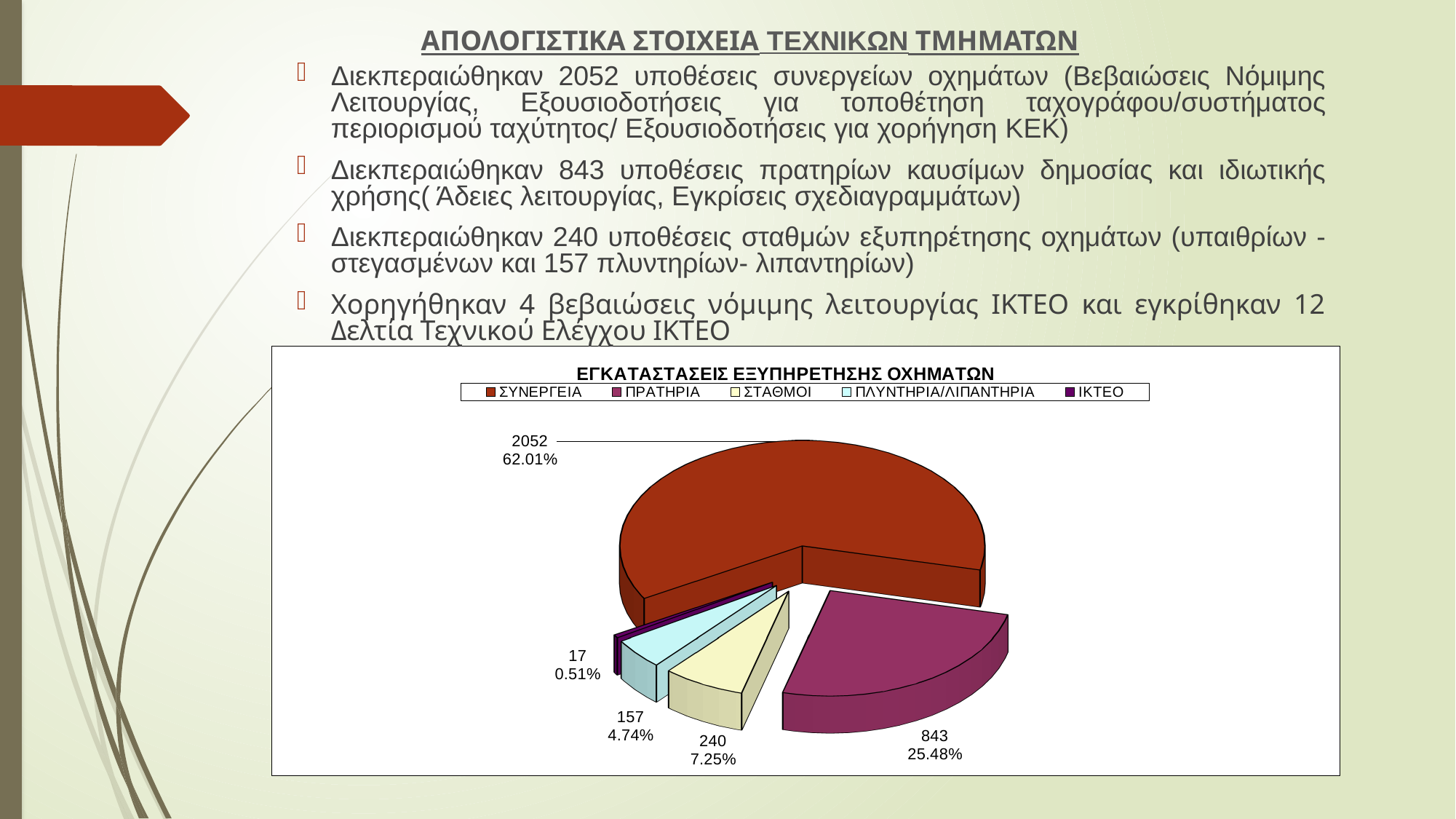
What is the value of the ΠΛΥΝΤΗΡΙΑ/ΛΙΠΑΝΤΗΡΙΑ slice? 157 What kind of chart is shown on the slide? pie chart What is the value of the ΠΡΑΤΗΡΙΑ slice? 843 How many categories does the legend of the pie chart list? 5 Which category has the largest slice of the pie? ΣΥΝΕΡΓΕΙΑ What share of the pie does the ΠΡΑΤΗΡΙΑ slice represent? 25.48% What is the title of the chart? ΕΓΚΑΤΑΣΤΑΣΕΙΣ ΕΞΥΠΗΡΕΤΗΣΗΣ ΟΧΗΜΑΤΩΝ What is the value of the ΣΥΝΕΡΓΕΙΑ slice? 2052 Which category has the smallest slice of the pie? ΙΚΤΕΟ What is the value of the ΙΚΤΕΟ slice? 17 What is the difference between the ΣΥΝΕΡΓΕΙΑ value and the ΠΡΑΤΗΡΙΑ value? 1209 What is the value of the ΣΤΑΘΜΟΙ slice? 240